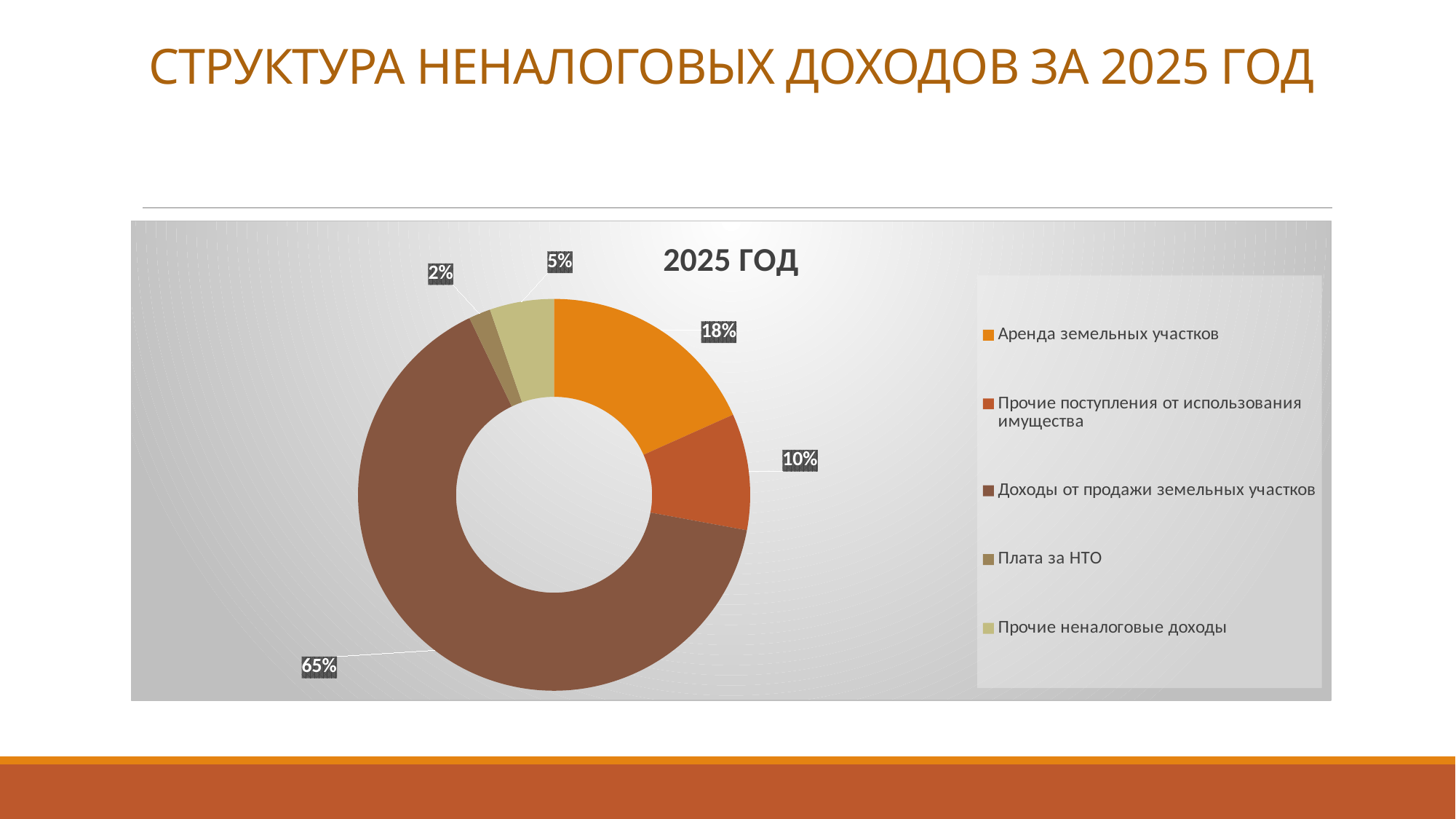
Сколько категорий показано на диаграмме? 5 Какой заголовок у диаграммы? 2025 ГОД Какая категория имеет наибольшую долю на диаграмме? Доходы от продажи земельных участков На сколько процентных пунктов доля «Доходы от продажи земельных участков» больше доли «Аренда земельных участков»? 47 Какую долю составляет «Плата за НТО»? 2% Какую долю составляют «Доходы от продажи земельных участков»? 65% Какую долю составляют «Прочие поступления от использования имущества»? 10% Какую долю составляет «Аренда земельных участков» на диаграмме? 18% Какой тип диаграммы показан на слайде? Кольцевая (круговая) диаграмма Какую долю составляют «Прочие неналоговые доходы»? 5% Что больше: доля «Аренда земельных участков» или доля «Прочие поступления от использования имущества»? Аренда земельных участков Какая категория имеет наименьшую долю на диаграмме? Плата за НТО